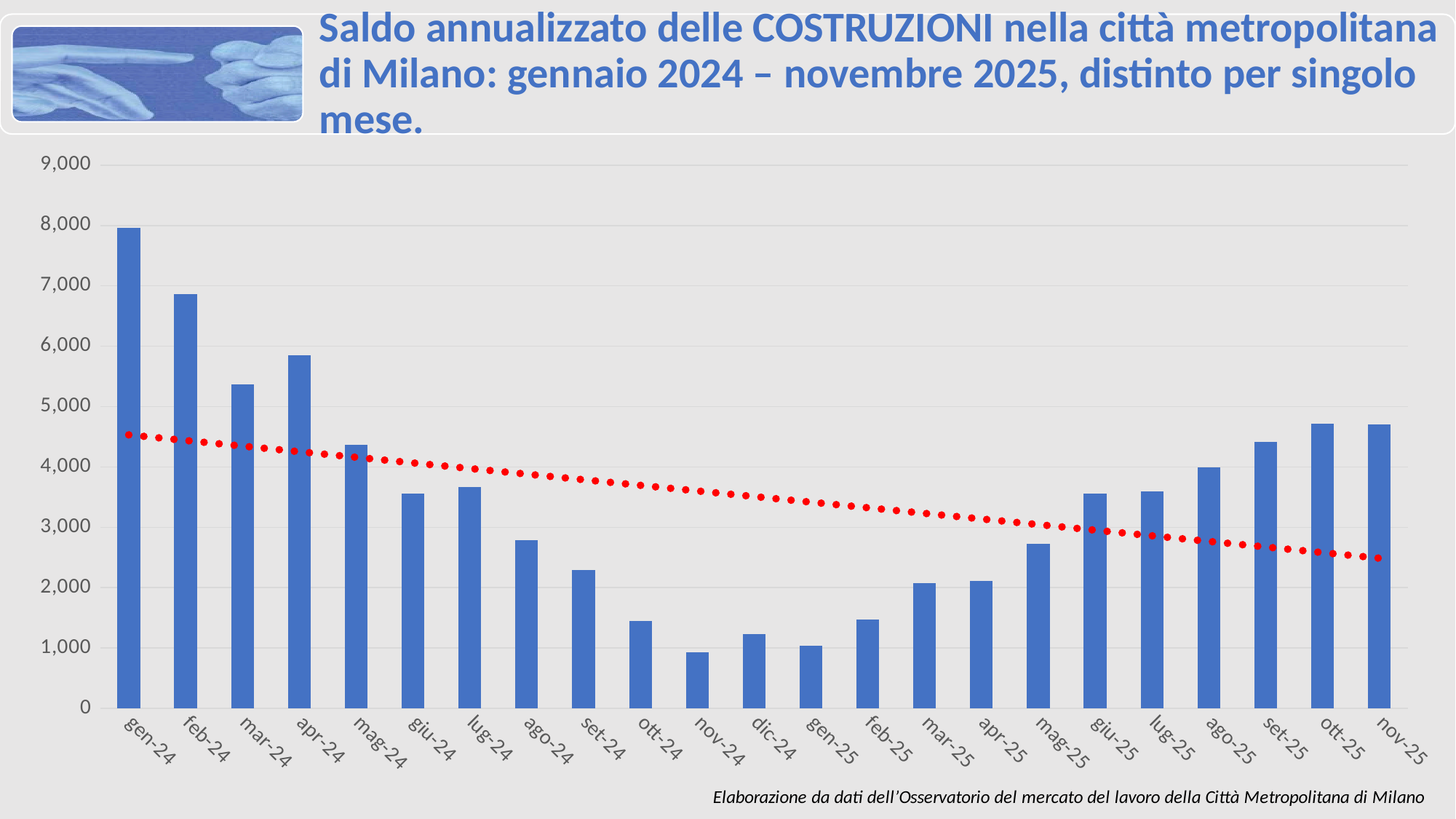
Is the value for set-25 greater or less than 4,000? greater What kind of chart is shown on the slide? bar chart Which is larger, the value for gen-24 or the value for feb-24? gen-24 Is the value for giu-25 greater or less than 3,000? greater Is the value for gen-24 greater or less than 7,000? greater How many months (bars) are plotted in the chart? 23 Which month has the lowest value in the chart? nov-24 Which is larger, the value for ago-24 or the value for mar-25? ago-24 Which month has the highest value in the chart? gen-24 What colour is the dotted trend line drawn across the chart? red Do the bar values rise or fall from gen-24 to nov-24? fall